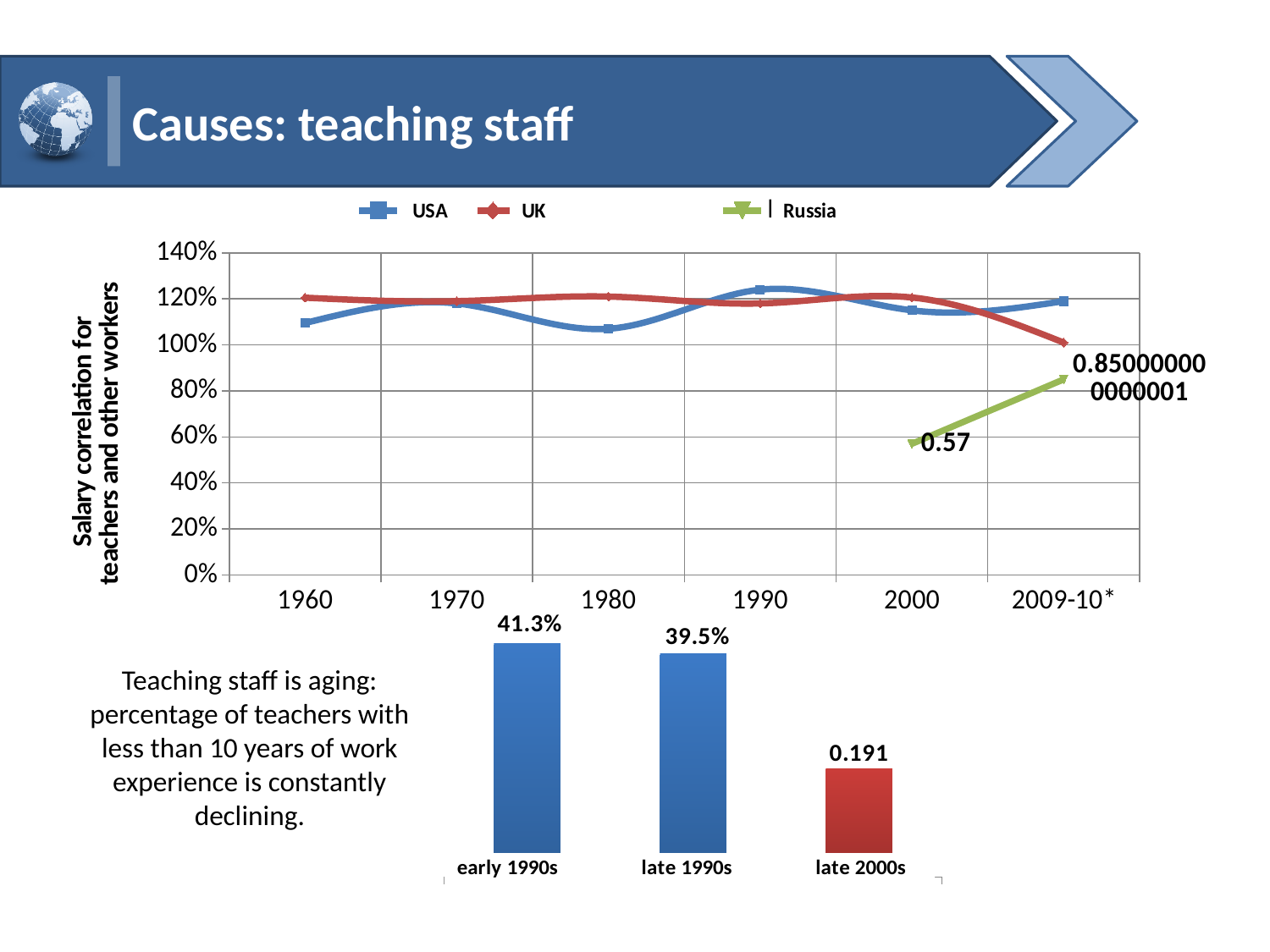
How many points are on the x axis of the top chart? 6 In the top chart, is the value for UK in 2009-10* greater or less than 120%? less How many series does the legend of the top chart list? 3 What kind of chart is the bottom chart on the slide (early 1990s, late 1990s, late 2000s)? bar chart What kind of chart is the top chart on the slide (salary correlation for teachers and other workers)? line chart In the bottom chart, which category has the lowest value? late 2000s What is the y-axis title of the top chart? Salary correlation for teachers and other workers In the top chart, what is the value for Russia in 2000? 0.57 In the bottom chart, what is the value for early 1990s? 41.3% In the bottom chart, what is the difference between the early 1990s and late 1990s values? 1.8% In the top chart, does the Russia series rise or fall from 2000 to 2009-10*? rise In the top chart, is the value for USA in 1980 greater or less than 100%? greater